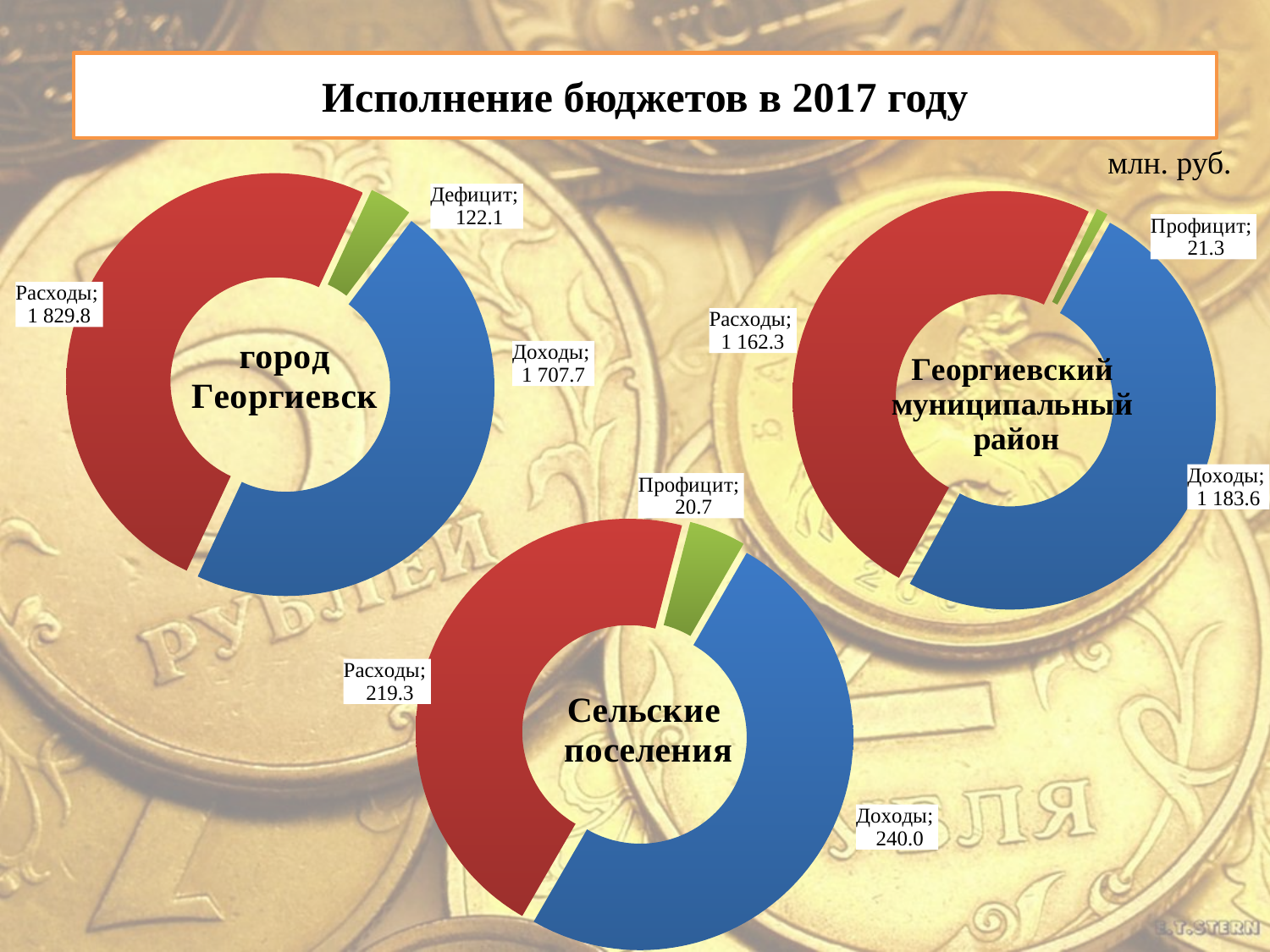
In the "Сельские поселения" chart, which category has the largest value? Доходы How many slices does the "Георгиевский муниципальный район" chart have? 3 In the "Сельские поселения" chart, what is the difference between Доходы and Расходы? 20.7 In the "Георгиевский муниципальный район" chart, what is the value for Доходы? 1 183.6 In the "город Георгиевск" chart, what is the value for Доходы? 1 707.7 In the "город Георгиевск" chart, which category has the smallest value? Дефицит In the "город Георгиевск" chart, what is the value for Расходы? 1 829.8 In the "город Георгиевск" chart, what is the value for Дефицит? 122.1 In the "Сельские поселения" chart, what is the value for Расходы? 219.3 What kind of chart is used for "Сельские поселения"? Doughnut (pie) chart In the "Георгиевский муниципальный район" chart, which is larger, Доходы or Расходы? Доходы In the "Георгиевский муниципальный район" chart, what is the value for Профицит? 21.3